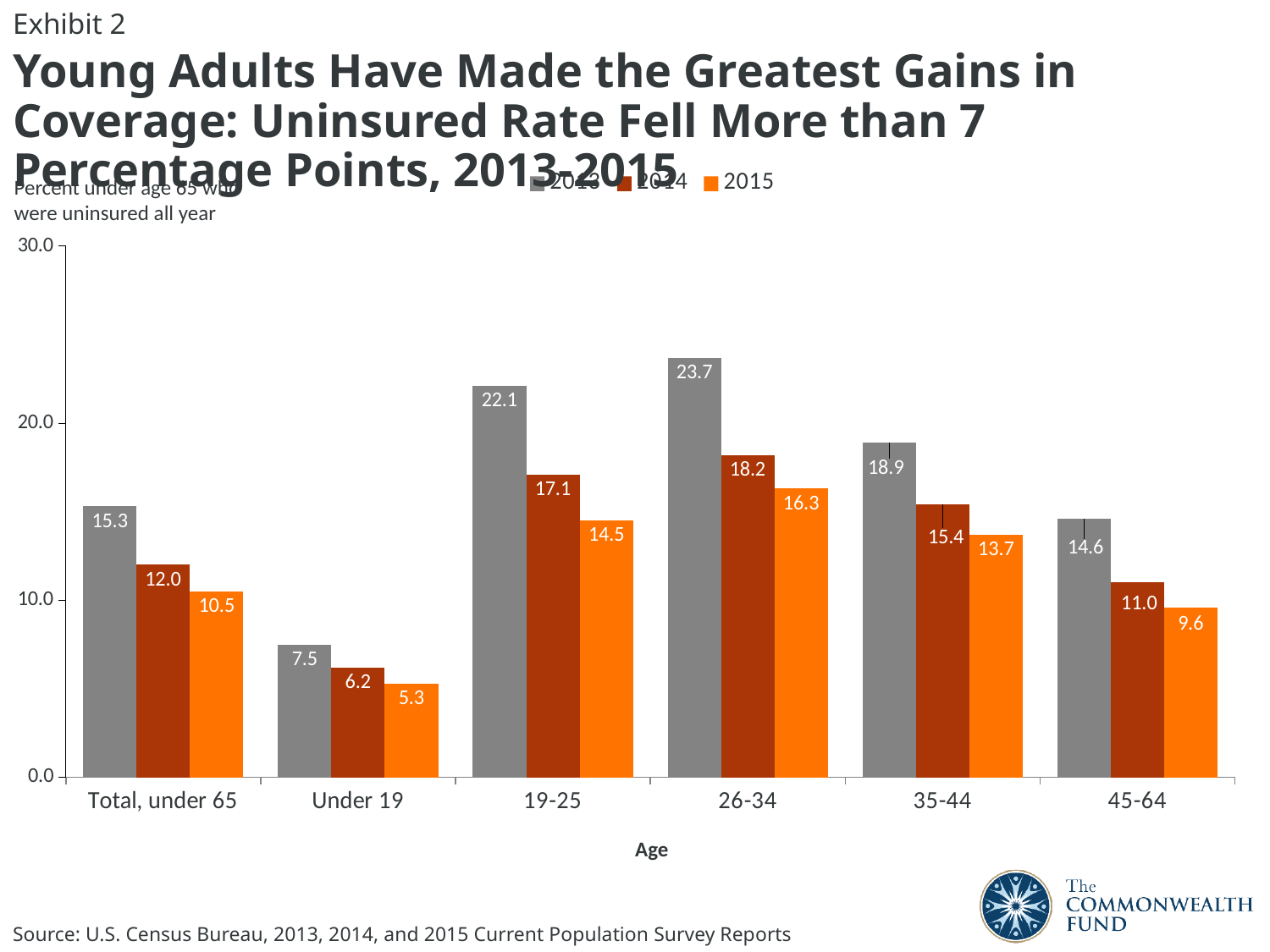
Which age category had the highest uninsured rate in 2013? 26-34 What was the uninsured rate for Total, under 65 in 2014? 12.0 What is the difference between the 2014 uninsured rates for the 26-34 and 35-44 age groups? 2.8 How many age categories are shown on the x axis? 6 Which age category had the lowest uninsured rate in 2015? Under 19 What was the uninsured rate for the 19-25 age group in 2013? 22.1 By how many percentage points did the uninsured rate for the 19-25 age group fall from 2013 to 2015? 7.6 How many series does the legend list? 3 What was the uninsured rate for the 45-64 age group in 2015? 9.6 Which had a higher uninsured rate in 2015: the 35-44 age group or the 45-64 age group? 35-44 What kind of chart is shown on the slide? Bar chart Within each age category, do the uninsured rates rise or fall from 2013 to 2015? Fall